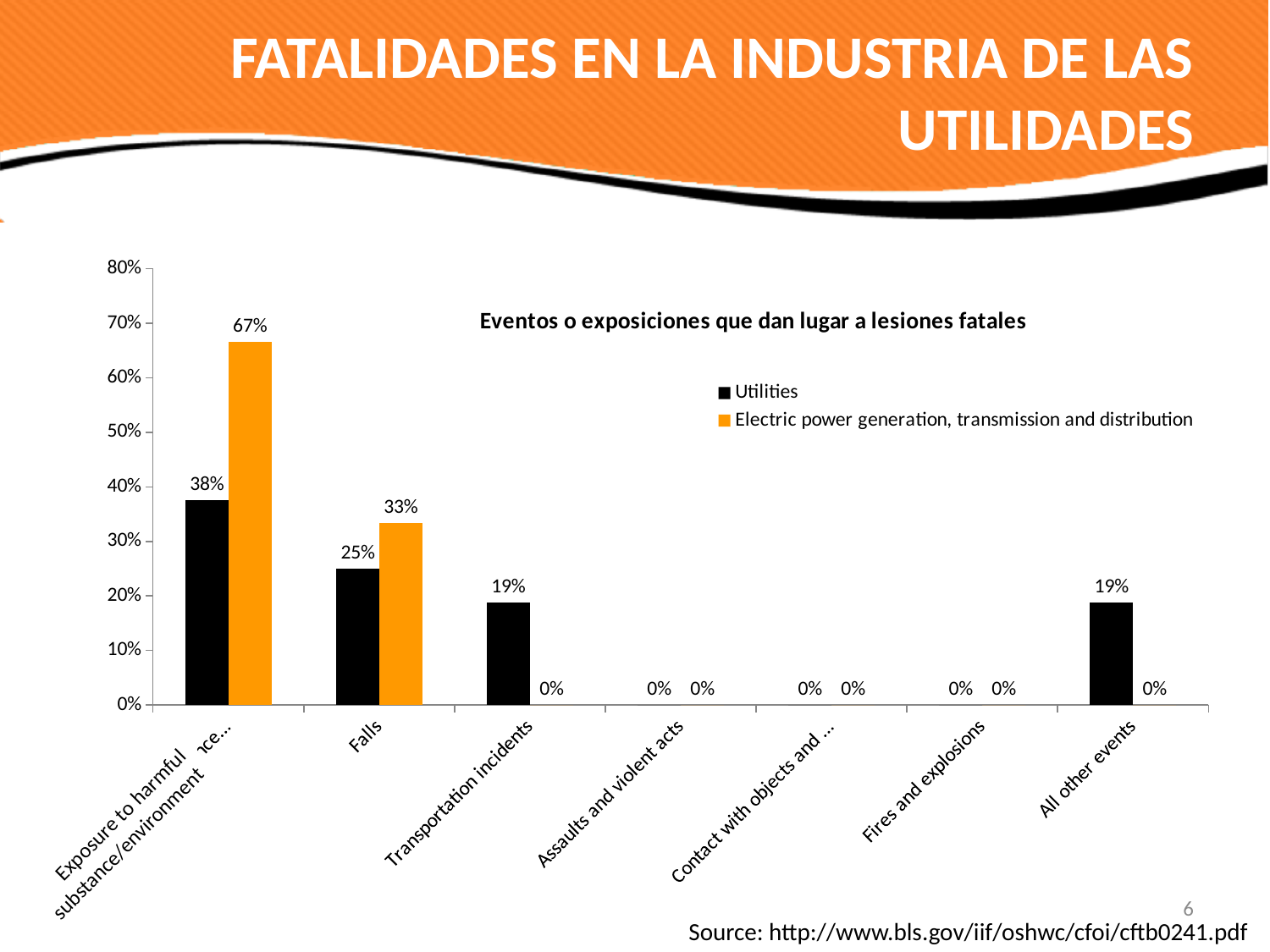
What type of chart is shown on the slide? Bar chart For Transportation incidents, which series has the larger value? Utilities Which category has the highest value in the Electric power generation, transmission and distribution series? Exposure to harmful substance/environment Is the Utilities value for Exposure to harmful substance/environment greater or less than 30%? greater What is the value for Transportation incidents in the Utilities series? 19% What is the difference between the Electric power generation, transmission and distribution value and the Utilities value for Falls? 8% What is the value for Falls in the Electric power generation, transmission and distribution series? 33% How many series does the legend list? 2 What is the difference between the two series' values for Exposure to harmful substance/environment? 29% How many categories are shown on the x axis? 7 What is the value for All other events in the Utilities series? 19% What is the value for Falls in the Utilities series? 25%